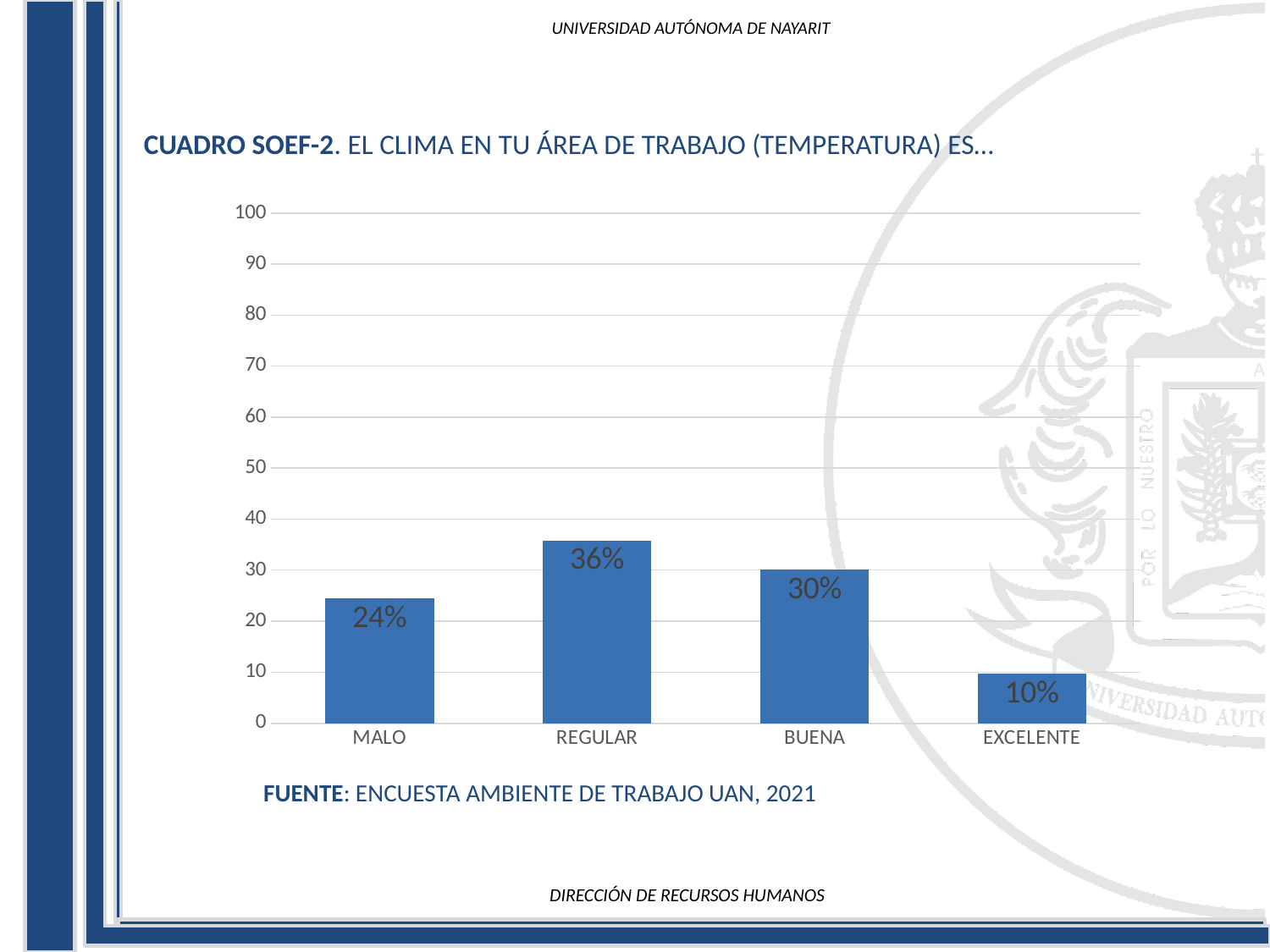
What is the value for MALO? 24% What is the difference between the values for MALO and EXCELENTE? 14% Which is larger, the value for MALO or the value for BUENA? BUENA How many categories are shown on the x axis? 4 Which category has the lowest value? EXCELENTE What is the difference between the values for REGULAR and BUENA? 6% What source is cited below the chart? ENCUESTA AMBIENTE DE TRABAJO UAN, 2021 What is the value for REGULAR? 36% What is the value for EXCELENTE? 10% What kind of chart is shown on the slide? bar chart Which category has the highest value? REGULAR Is the value for BUENA greater or less than 40? less